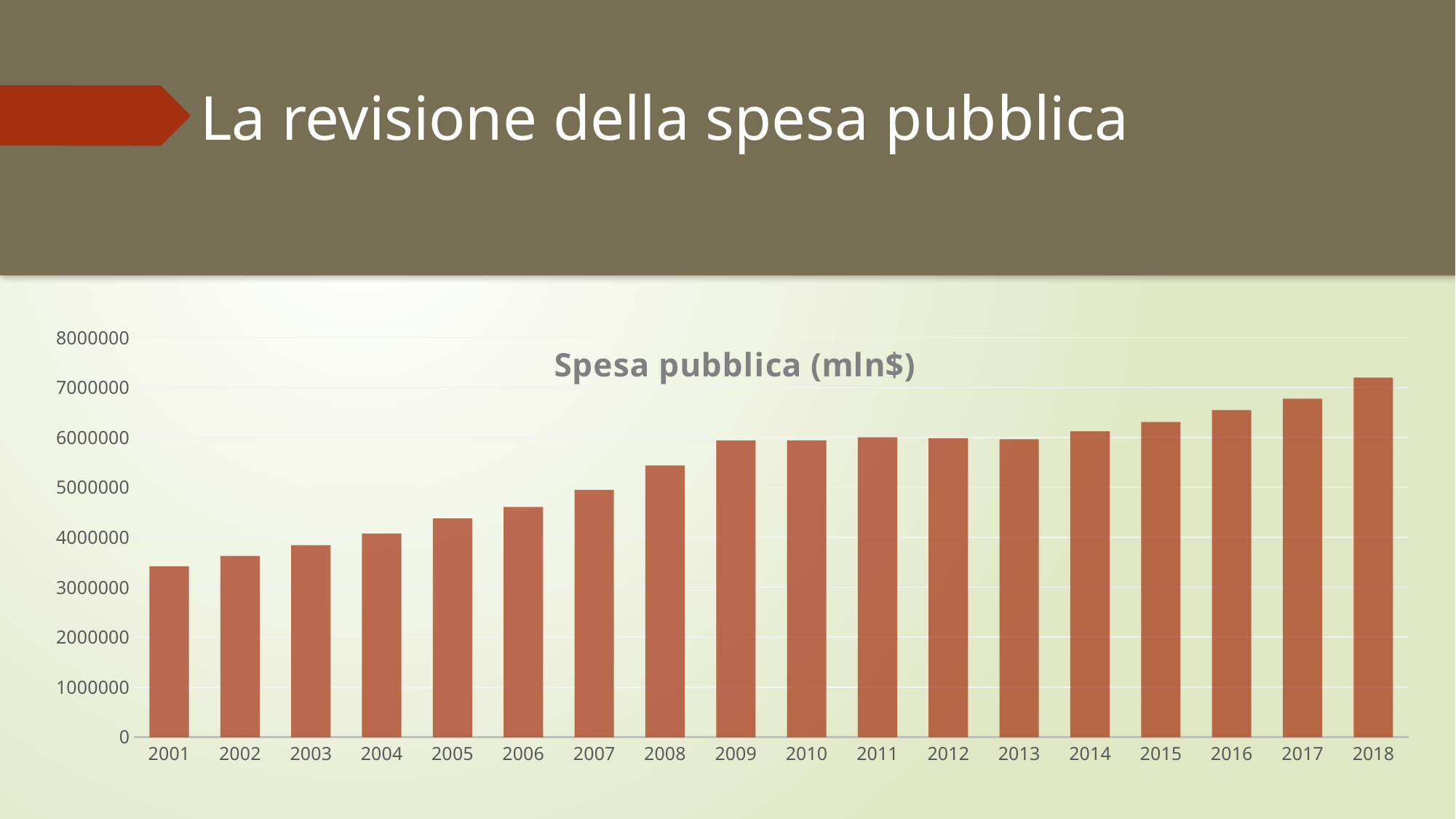
Do the values generally rise or fall from 2001 to 2018? rise Which is larger, the value for 2004 or the value for 2015? 2015 Is the value for 2006 greater or less than 5000000? less What kind of chart is shown on the slide? bar chart Is the value for 2008 greater or less than 5000000? greater Which year has the lowest value? 2001 Which year has the highest value? 2018 Is the value for 2001 greater or less than 4000000? less What is the title of the chart? Spesa pubblica (mln$) How many years are plotted on the chart? 18